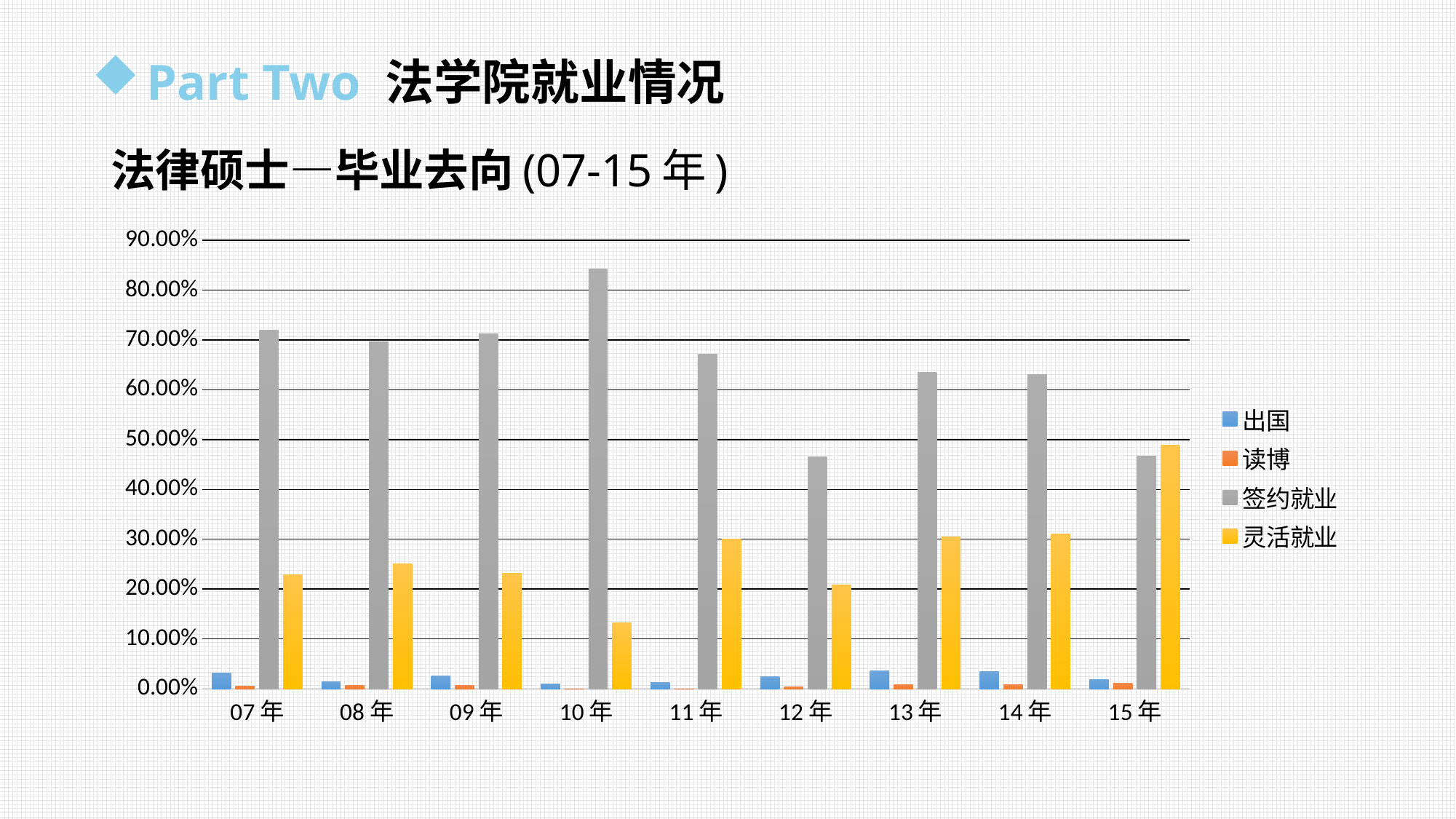
In which year is the value for 签约就业 the highest? 10年 In 13年, which is larger: 出国 or 读博? 出国 How many year categories are shown on the x axis? 9 Does the value for 灵活就业 rise or fall from 12年 to 15年? rise Is the value for 灵活就业 in 08年 greater or less than 20.00%? greater In which year is the value for 灵活就业 the lowest? 10年 In which year is the value for 灵活就业 the highest? 15年 Is the value for 签约就业 in 10年 greater or less than 80.00%? greater Is the value for 签约就业 in 12年 greater or less than 50.00%? less In 07年, which is larger: 签约就业 or 灵活就业? 签约就业 How many series does the legend list? 4 What kind of chart is shown on the slide? bar chart